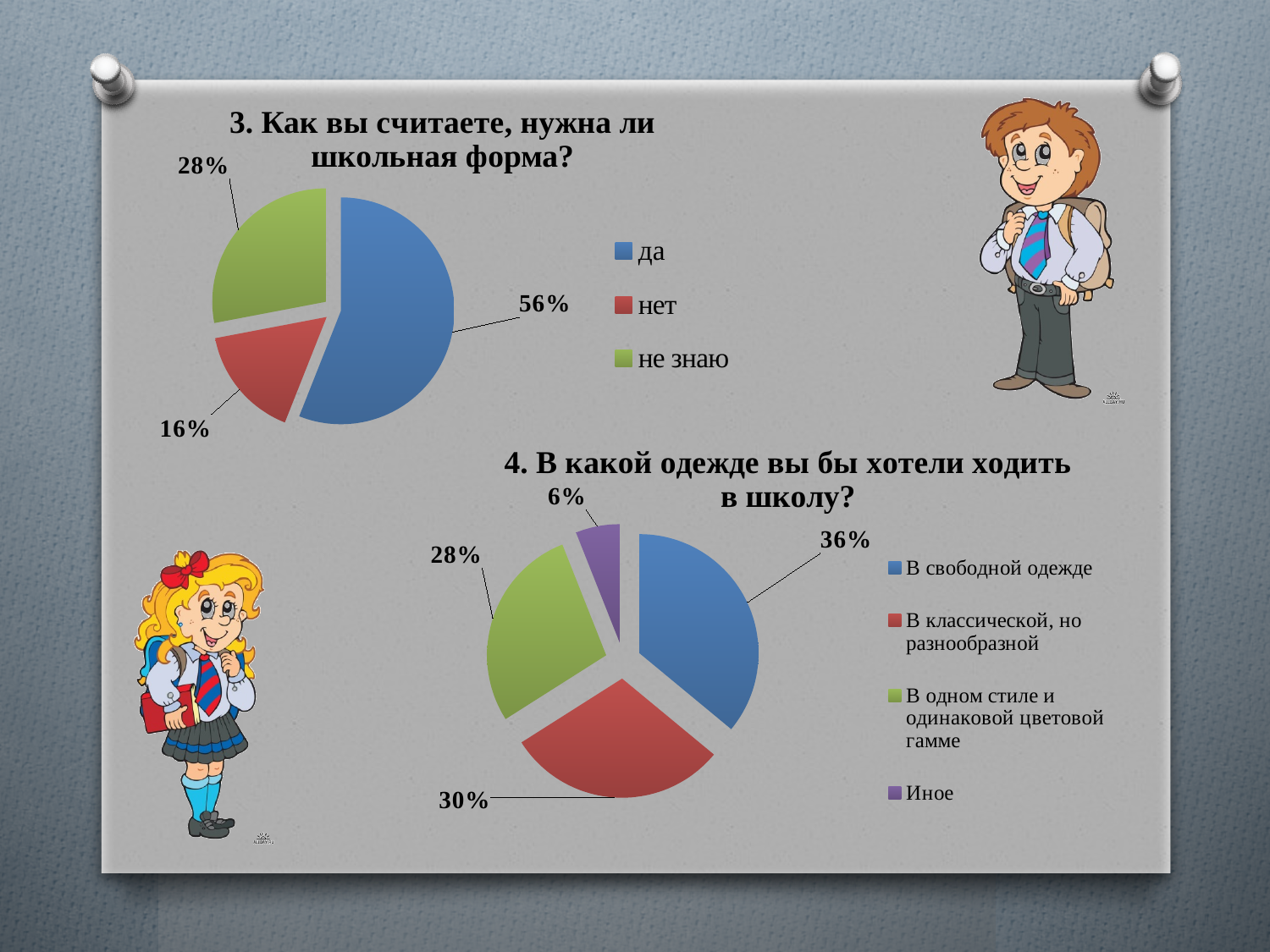
In the chart titled "4. В какой одежде вы бы хотели ходить в школу?", which is larger: "В классической, но разнообразной" or "В одном стиле и одинаковой цветовой гамме"? В классической, но разнообразной In the chart titled "3. Как вы считаете, нужна ли школьная форма?", what share of respondents answered "нет"? 16% In the chart titled "3. Как вы считаете, нужна ли школьная форма?", which answer has the largest slice? да In the chart titled "3. Как вы считаете, нужна ли школьная форма?", which answer has the smallest slice? нет In the chart titled "4. В какой одежде вы бы хотели ходить в школу?", what share chose "Иное"? 6% In the chart titled "4. В какой одежде вы бы хотели ходить в школу?", how many categories does the legend list? 4 In the chart titled "3. Как вы считаете, нужна ли школьная форма?", how many categories does the legend list? 3 In the chart titled "3. Как вы считаете, нужна ли школьная форма?", what share of respondents answered "да"? 56% In the chart titled "3. Как вы считаете, нужна ли школьная форма?", what is the difference in percentage points between "да" and "не знаю"? 28 What type of chart is the chart titled "4. В какой одежде вы бы хотели ходить в школу?"? Pie chart In the chart titled "4. В какой одежде вы бы хотели ходить в школу?", which option has the smallest slice? Иное In the chart titled "4. В какой одежде вы бы хотели ходить в школу?", what share chose "В свободной одежде"? 36%